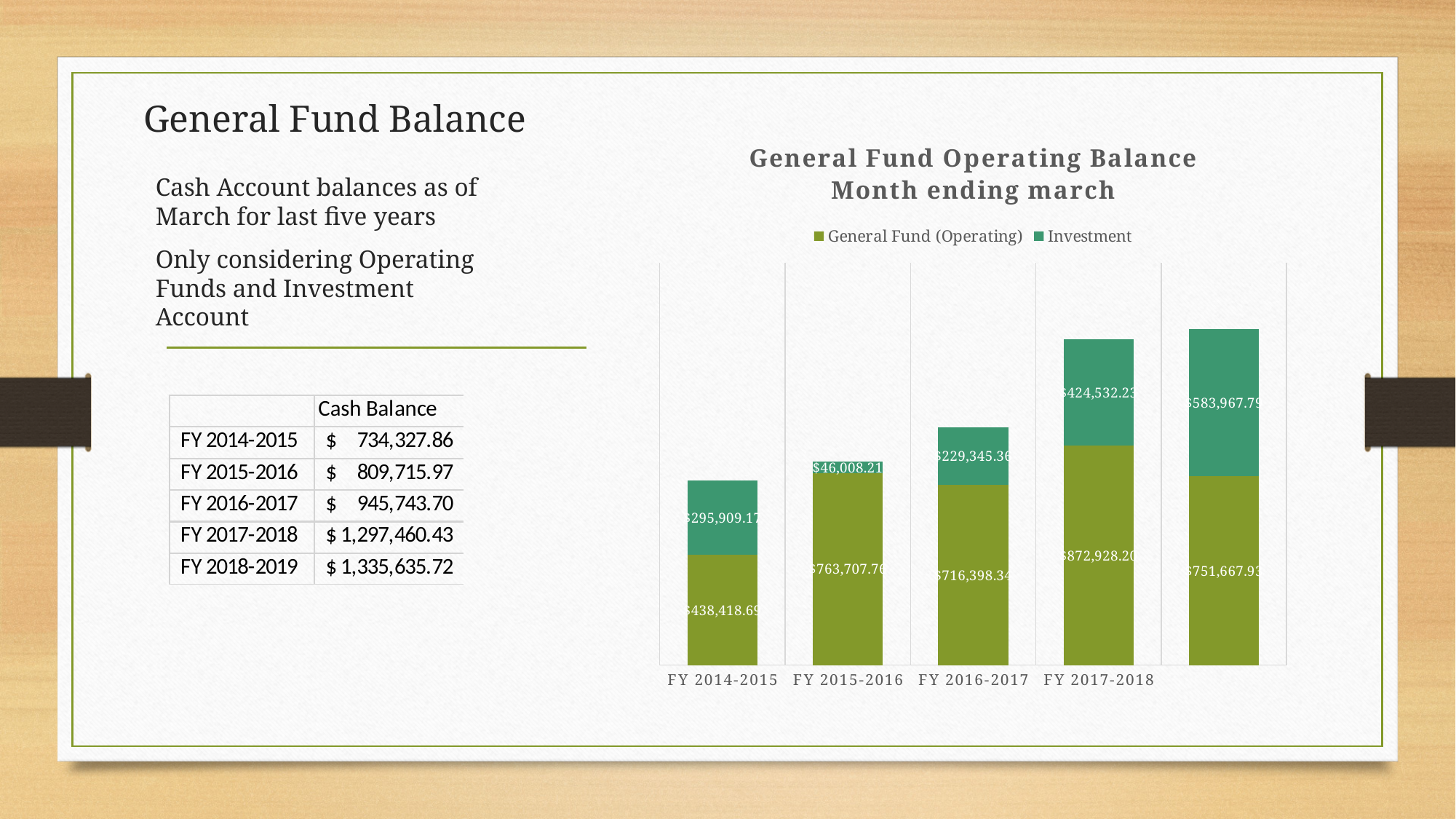
What is the total of the stacked bar for FY 2014-2015? $734,327.86 What kind of chart is shown on the slide? Stacked bar chart How much larger is the Investment value for FY 2017-2018 than for FY 2016-2017? $195,186.87 How many series does the chart legend list? 2 Does the Investment value rise or fall from FY 2014-2015 to FY 2015-2016? Fall What are the two series named in the chart legend? General Fund (Operating) and Investment Among the labeled fiscal years, which has the highest General Fund (Operating) value? FY 2017-2018 What is the General Fund (Operating) value for FY 2016-2017? $716,398.34 Among the labeled fiscal years, which has the lowest Investment value? FY 2015-2016 What is the Investment value for FY 2014-2015? $295,909.17 Which is larger, the General Fund (Operating) value for FY 2015-2016 or for FY 2016-2017? FY 2015-2016 What is the Investment value for FY 2015-2016? $46,008.21